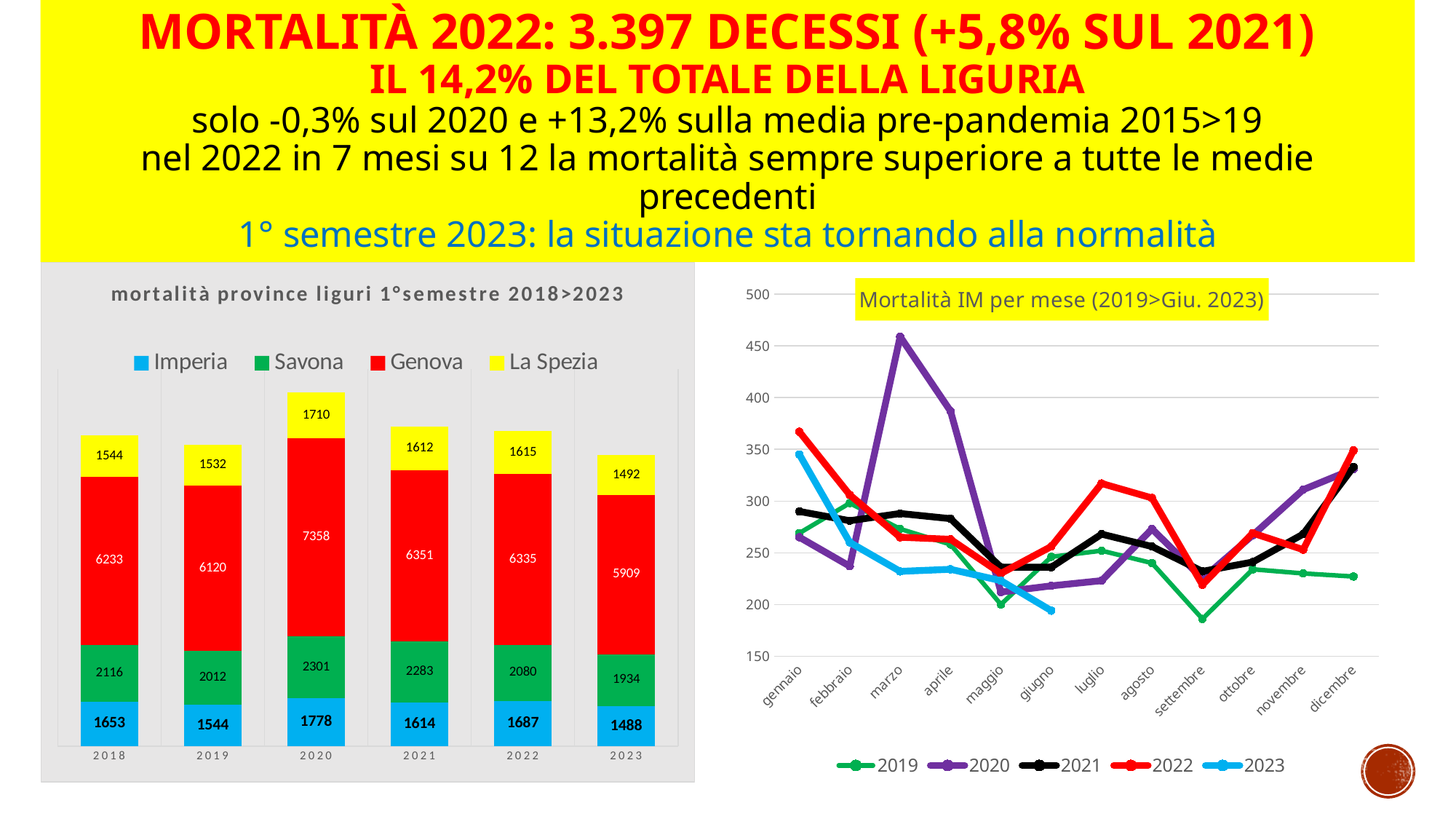
What kind of chart is the chart on the left of the slide? Stacked bar chart In the chart 'mortalità province liguri 1°semestre 2018>2023', in which year is the Savona value highest? 2020 In the chart 'mortalità province liguri 1°semestre 2018>2023', what is the value for La Spezia in 2021? 1612 In the chart 'mortalità province liguri 1°semestre 2018>2023', what is the value for Genova in 2020? 7358 In the chart 'mortalità province liguri 1°semestre 2018>2023', what is the value for Imperia in 2023? 1488 In the chart 'mortalità province liguri 1°semestre 2018>2023', what is the total of the stacked bar for 2020? 13147 In the chart 'Mortalità IM per mese (2019>Giu. 2023)', is the value for 2019 in settembre greater or less than 200? less In the chart 'Mortalità IM per mese (2019>Giu. 2023)', is the value for 2020 in marzo greater or less than 400? greater In the chart 'mortalità province liguri 1°semestre 2018>2023', in which year is the Genova value lowest? 2023 In the chart 'mortalità province liguri 1°semestre 2018>2023', what is the difference between the Genova values for 2020 and 2019? 1238 In the chart 'mortalità province liguri 1°semestre 2018>2023', how many series does the legend list? 4 In the chart 'Mortalità IM per mese (2019>Giu. 2023)', how many series does the legend list? 5